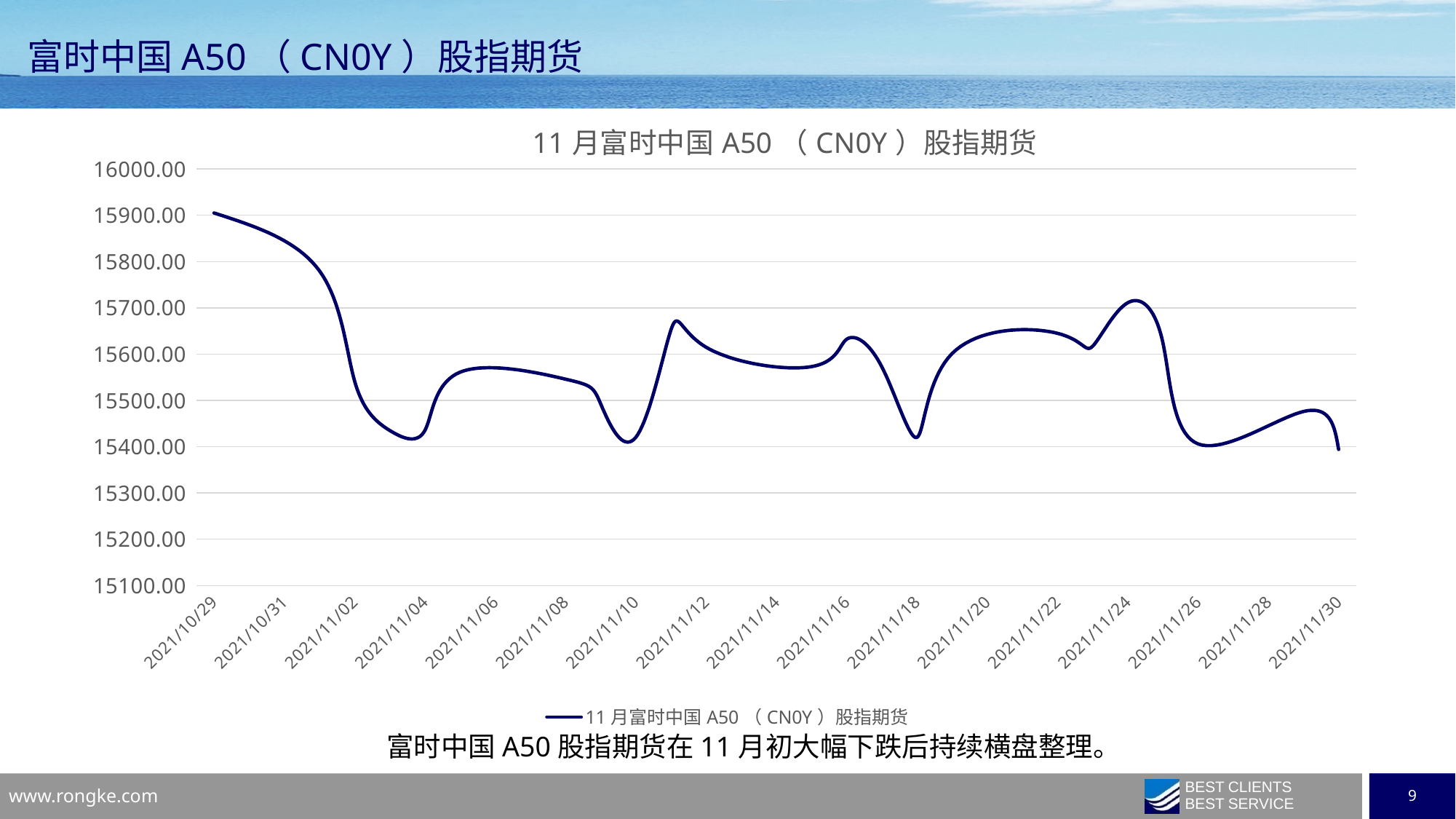
Is the value for 2021/11/24 greater or less than 15600? greater How many series does the legend list? 1 What is the title of the chart? 11月富时中国A50（CN0Y）股指期货 Which is larger, the value for 2021/10/29 or the value for 2021/11/30? 2021/10/29 What kind of chart is shown on the slide? line chart On which date does the line reach its highest value? 2021/10/29 Overall, do the values rise or fall from the start of the x axis to the end? fall Is the value for 2021/11/30 greater or less than 15500? less Which is larger, the value for 2021/11/24 or the value for 2021/11/18? 2021/11/24 Is the value for 2021/11/18 greater or less than 15500? less How many date labels are shown on the x axis? 17